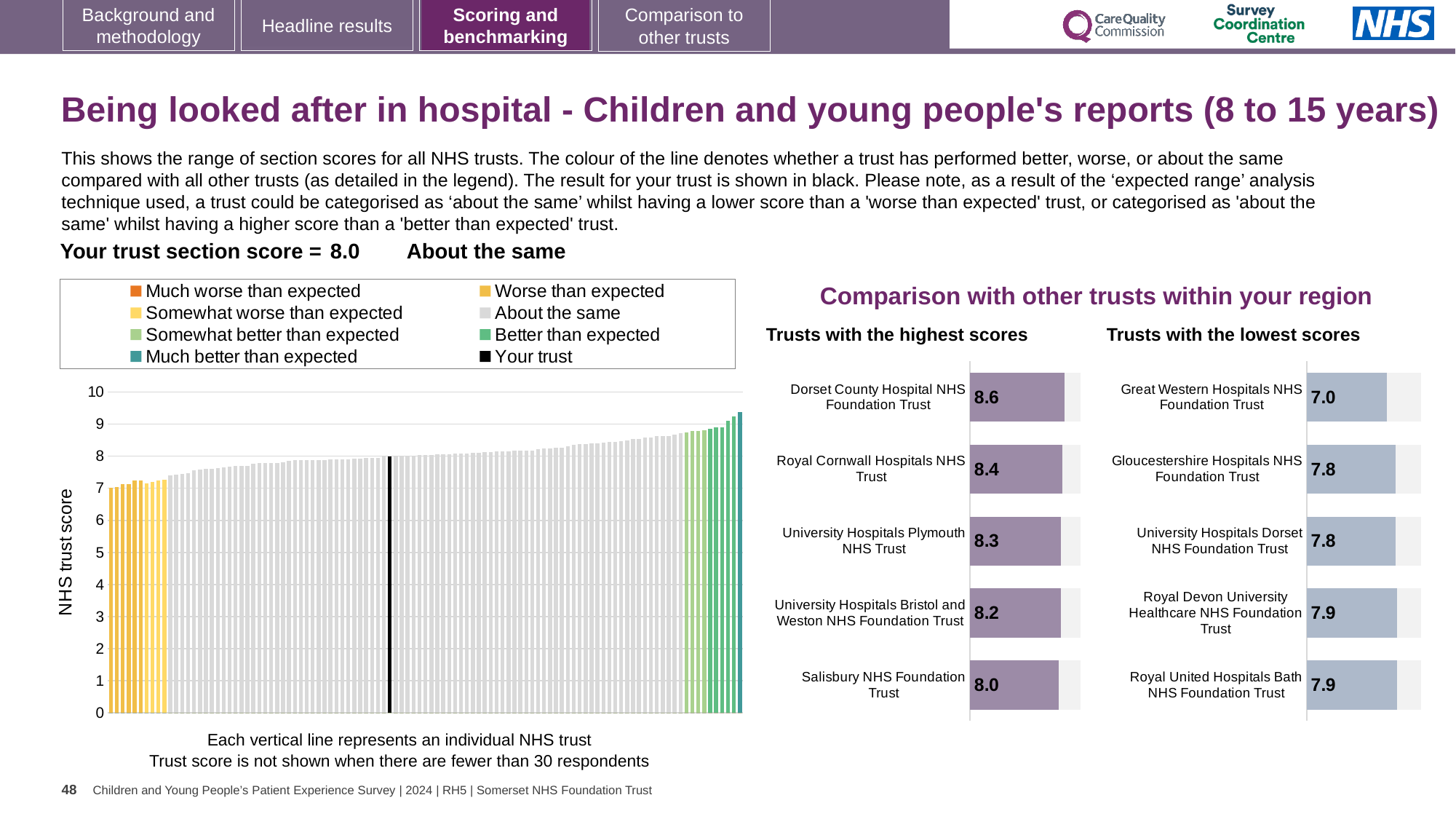
How many entries does the legend of the large chart on the left list? 8 In the 'Trusts with the highest scores' chart, what is the difference between the scores of Dorset County Hospital NHS Foundation Trust and Salisbury NHS Foundation Trust? 0.6 In the 'Trusts with the highest scores' chart, what is the score for Dorset County Hospital NHS Foundation Trust? 8.6 In the 'Trusts with the lowest scores' chart, what is the score for Great Western Hospitals NHS Foundation Trust? 7.0 In the large chart on the left, is the value of the leftmost bar greater or less than 6? greater In the large chart on the left, do the trust scores rise or fall from left to right? Rise How many trusts are listed in the 'Trusts with the lowest scores' chart? 5 What type of chart is the large chart on the left showing NHS trust scores? Bar chart In the 'Trusts with the lowest scores' chart, which trust has the lowest score? Great Western Hospitals NHS Foundation Trust In the 'Trusts with the highest scores' chart, which trust has the lowest score shown? Salisbury NHS Foundation Trust In the 'Trusts with the lowest scores' chart, what is the difference between the scores of Gloucestershire Hospitals NHS Foundation Trust and Great Western Hospitals NHS Foundation Trust? 0.8 In the 'Trusts with the highest scores' chart, which has the higher score: Royal Cornwall Hospitals NHS Trust or University Hospitals Plymouth NHS Trust? Royal Cornwall Hospitals NHS Trust